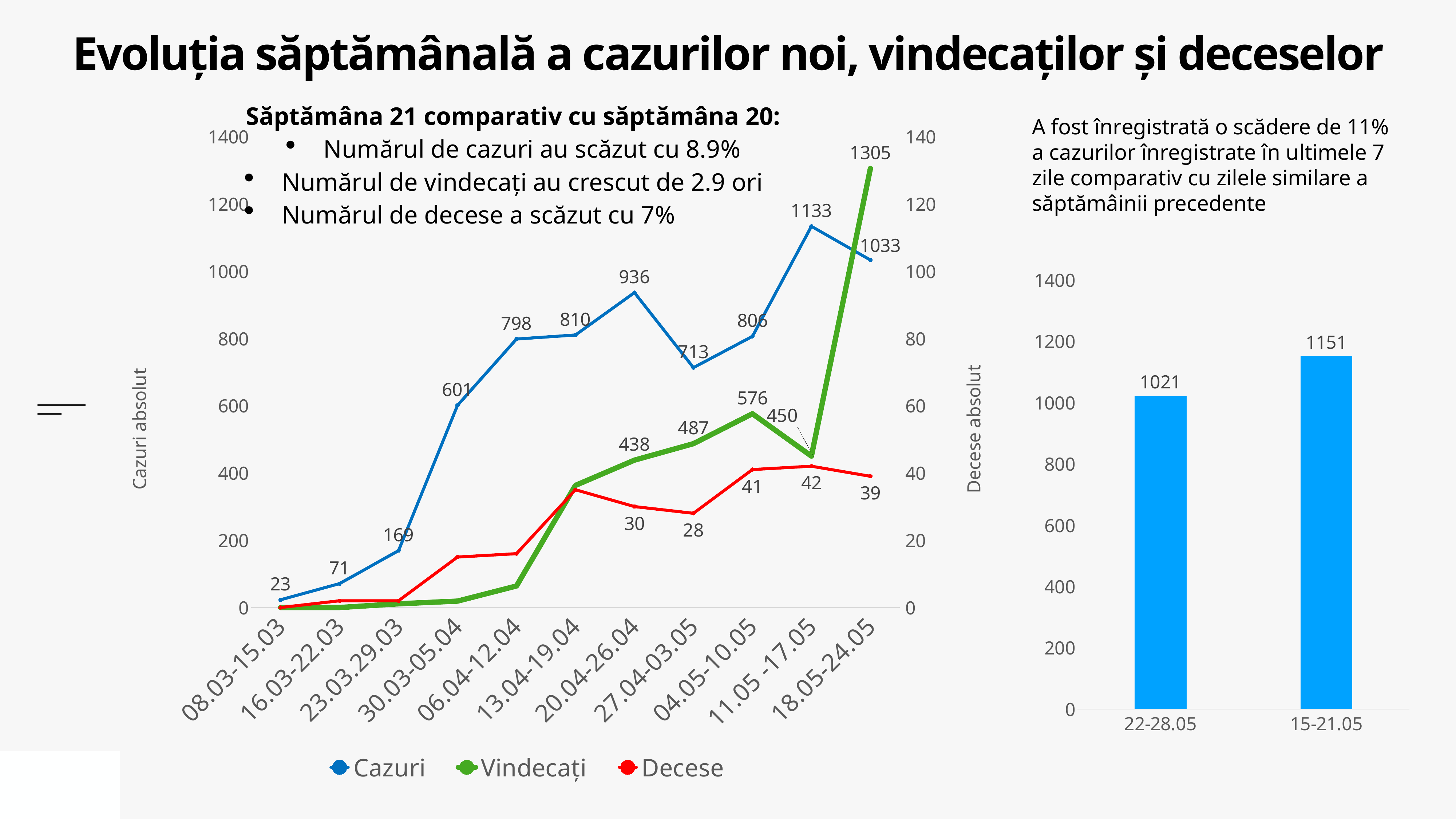
In the left line chart, what is the value of Cazuri for the week 20.04-26.04? 936 In the right bar chart, what is the value for 22-28.05? 1021 In the left line chart, what is the difference between Cazuri in 11.05-17.05 and in 18.05-24.05? 100 In the left line chart, how many weekly categories are shown on the x axis? 11 In the right bar chart, what is the difference between the values for 15-21.05 and 22-28.05? 130 In the left line chart, what is the value of Vindecați for the week 18.05-24.05? 1305 What kind of chart is the left chart, 'Cazuri absolut' vs 'Decese absolut' by week? line chart In the left line chart, how many series does the legend list? 3 What kind of chart is the right chart comparing 22-28.05 and 15-21.05? bar chart In the left line chart, is the value of Decese for the week 30.03-05.04 greater or less than 20? less In the left line chart, what is the value of Decese for the week 11.05-17.05? 42 In the left line chart, which week has the highest value for Cazuri? 11.05-17.05